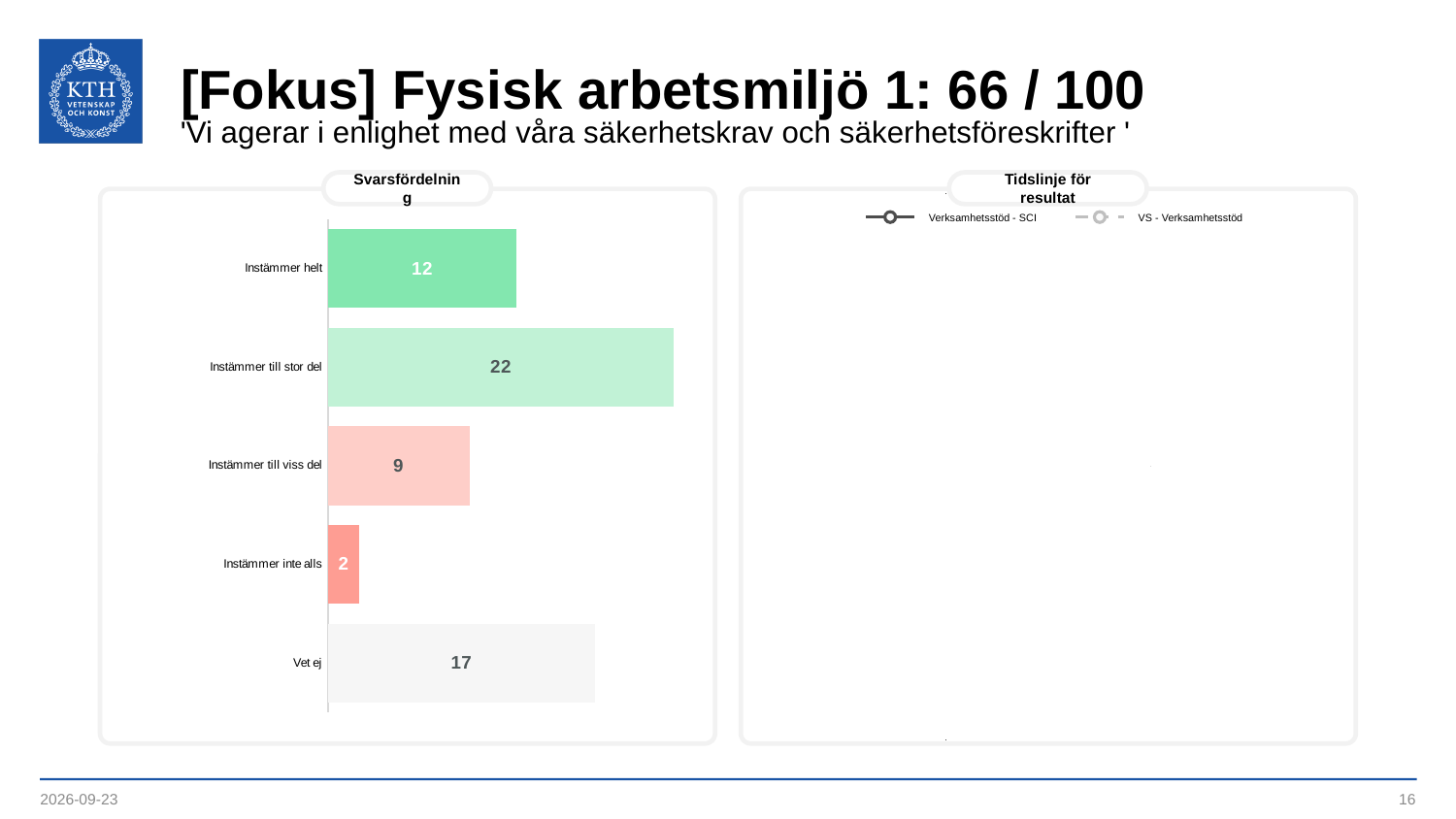
In the Svarsfördelning chart, which is larger: 'Instämmer helt' or 'Instämmer till viss del'? Instämmer helt What is the title of the chart on the right side of the slide? Tidslinje för resultat What kind of chart is the Svarsfördelning chart? Bar chart How many series does the legend of the 'Tidslinje för resultat' chart list? 2 In the Svarsfördelning chart, which category has the lowest value? Instämmer inte alls How many categories does the Svarsfördelning chart show? 5 In the Svarsfördelning chart, which category has the highest value? Instämmer till stor del In the Svarsfördelning chart, what is the difference between 'Vet ej' and 'Instämmer till viss del'? 8 In the Svarsfördelning chart, what is the difference between 'Instämmer till stor del' and 'Instämmer helt'? 10 In the Svarsfördelning chart, what is the value for 'Instämmer inte alls'? 2 In the Svarsfördelning chart, what is the value for 'Instämmer till stor del'? 22 In the Svarsfördelning chart, what is the value for 'Vet ej'? 17